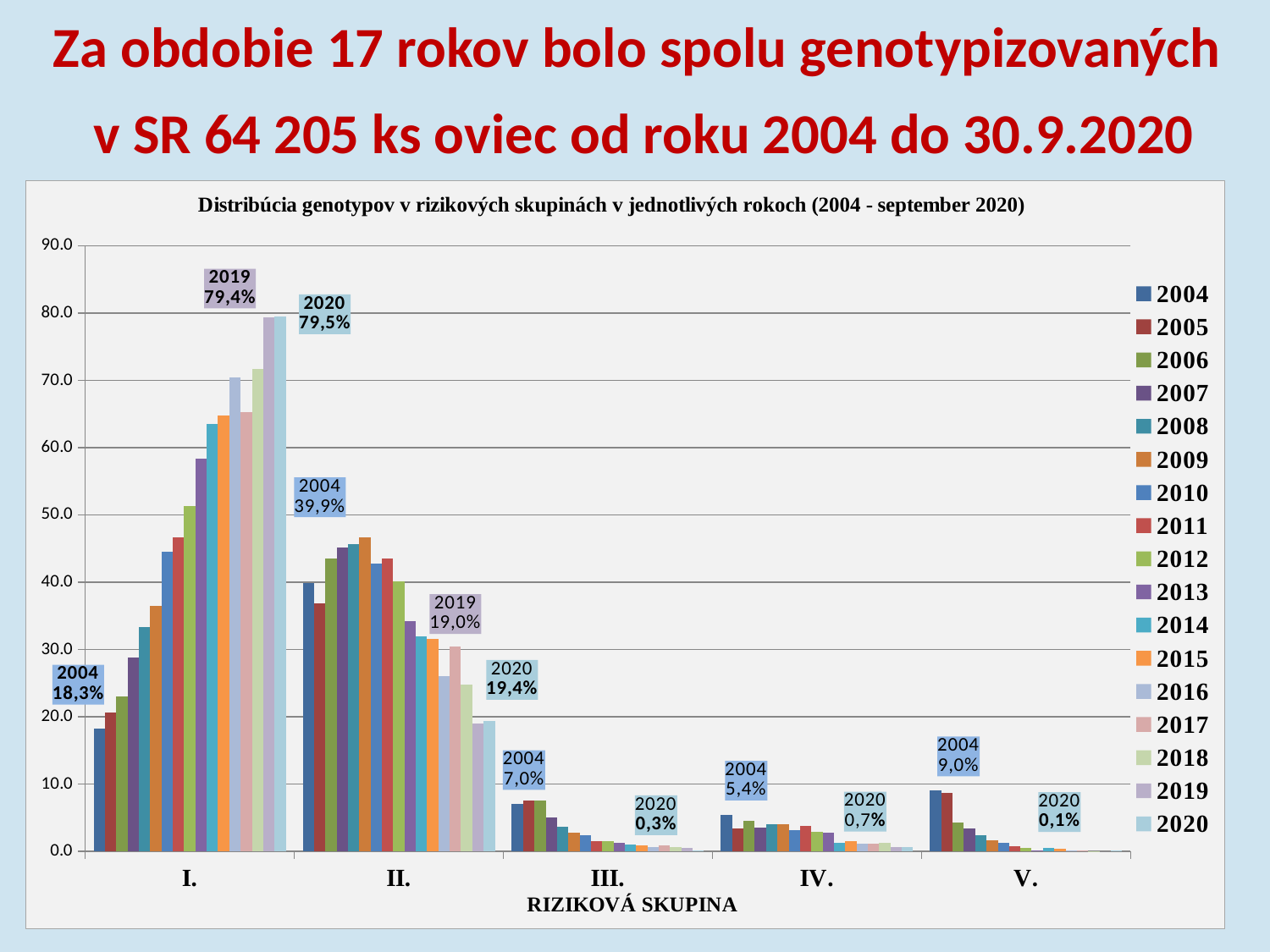
What kind of chart is shown on the slide? bar chart What is the title of the chart? Distribúcia genotypov v rizikových skupinách v jednotlivých rokoch (2004 - september 2020) Which risk group has the lowest value for 2020? V. How many series does the legend list? 17 Is the value for 2013 in risk group I. greater or less than 50? greater What is the difference between the 2020 and 2004 values in risk group I.? 61,2% How many risk groups are shown on the x axis? 5 What is the value for 2004 in risk group I.? 18,3% Which is larger: the 2004 value in risk group I. or the 2004 value in risk group II.? Risk group II. What is the value for 2004 in risk group V.? 9,0% What is the value for 2019 in risk group II.? 19,0% What is the value for 2020 in risk group I.? 79,5%